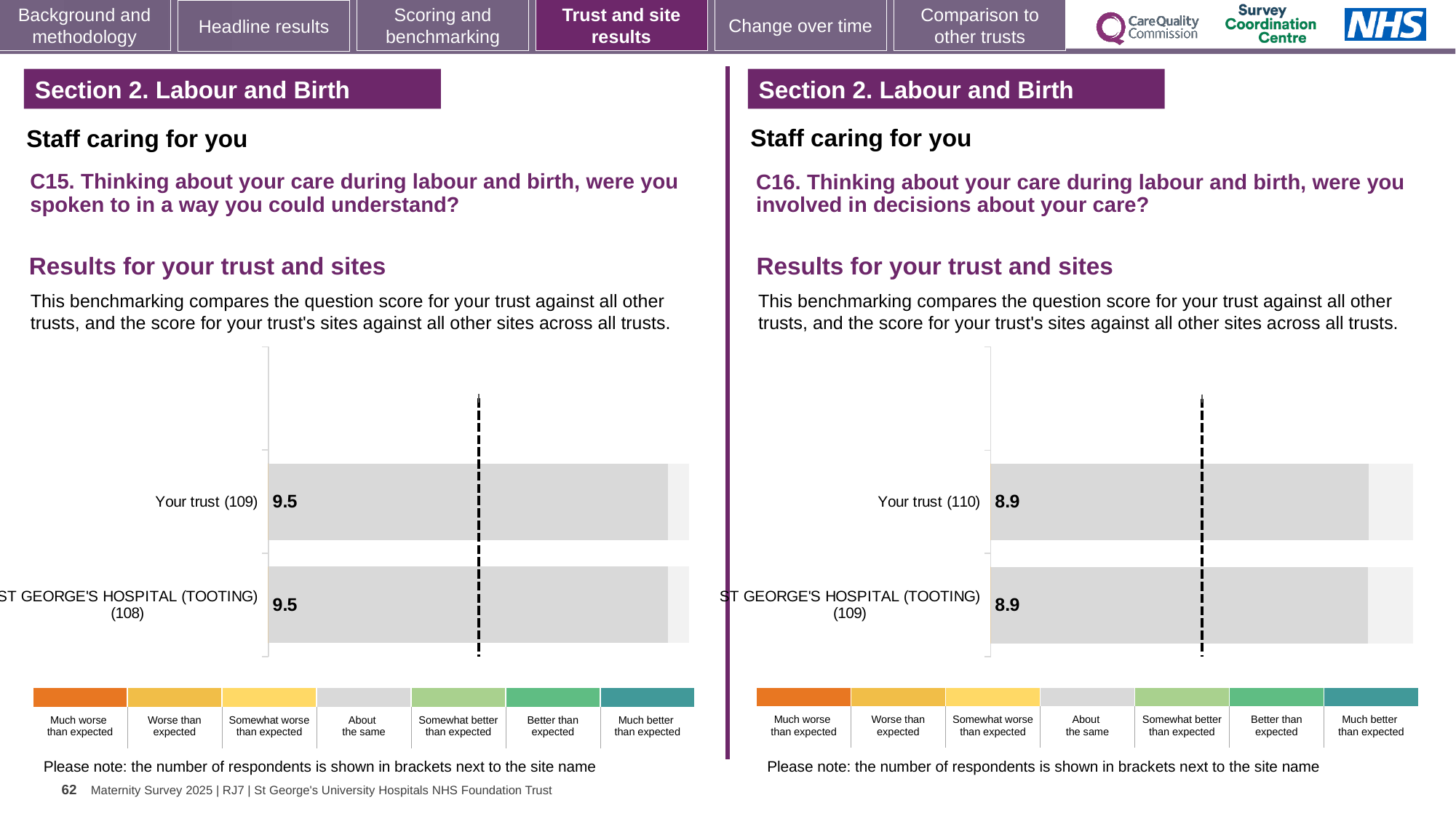
In the C15 chart on the left, what is the difference between the Your trust score and the St George's Hospital (Tooting) score? 0 How many bars are plotted in the C15 chart on the left? 2 How many bars are plotted in the C16 chart on the right? 2 In the C15 chart on the left, what is the score for St George's Hospital (Tooting)? 9.5 In the C15 chart on the left, what is the score for Your trust? 9.5 In the C16 chart on the right, what is the difference between the Your trust score and the St George's Hospital (Tooting) score? 0 In the C16 chart on the right, what is the score for Your trust? 8.9 Is the Your trust score in the C15 chart on the left larger or smaller than the Your trust score in the C16 chart on the right? Larger In the C16 chart on the right, how many respondents are shown in brackets for St George's Hospital (Tooting)? 109 What type of chart is used in the C15 chart on the left? Bar chart In the C16 chart on the right, what is the score for St George's Hospital (Tooting)? 8.9 In the C15 chart on the left, how many respondents are shown in brackets for Your trust? 109